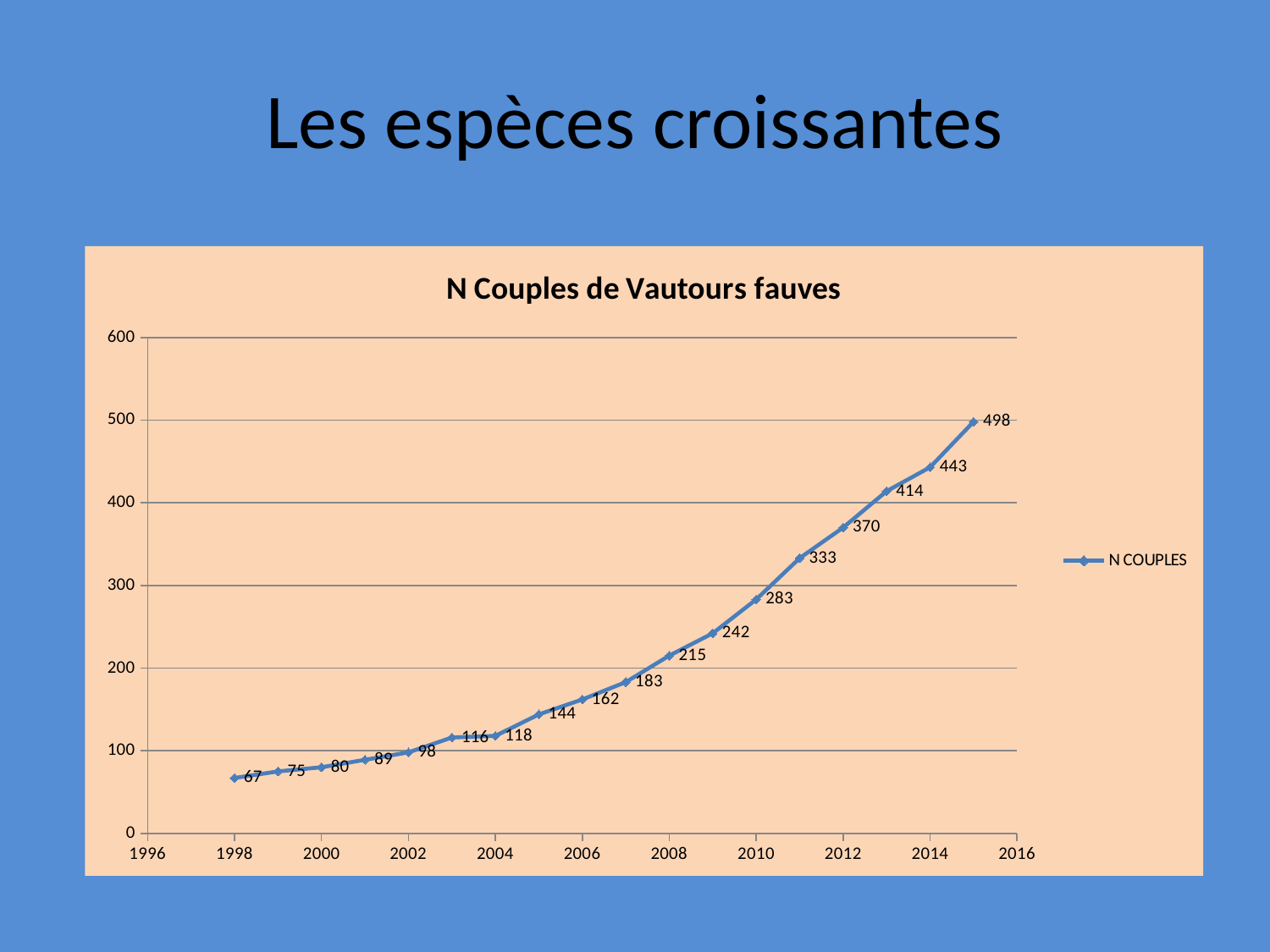
What is the lowest value plotted on the chart? 67 Which year has the larger value, 2008 or 2004? 2008 How many data points are plotted on the line? 18 Do the values rise or fall from 1998 to 2015? rise How many series does the legend list? 1 What is the value of N COUPLES in 2004? 118 What is the difference between the values for 2014 and 2010? 160 What is the value of N COUPLES in 2010? 283 What is the title of the chart? N Couples de Vautours fauves What is the value of N COUPLES in 2014? 443 What kind of chart is shown on the slide? line chart What is the highest value plotted on the chart? 498